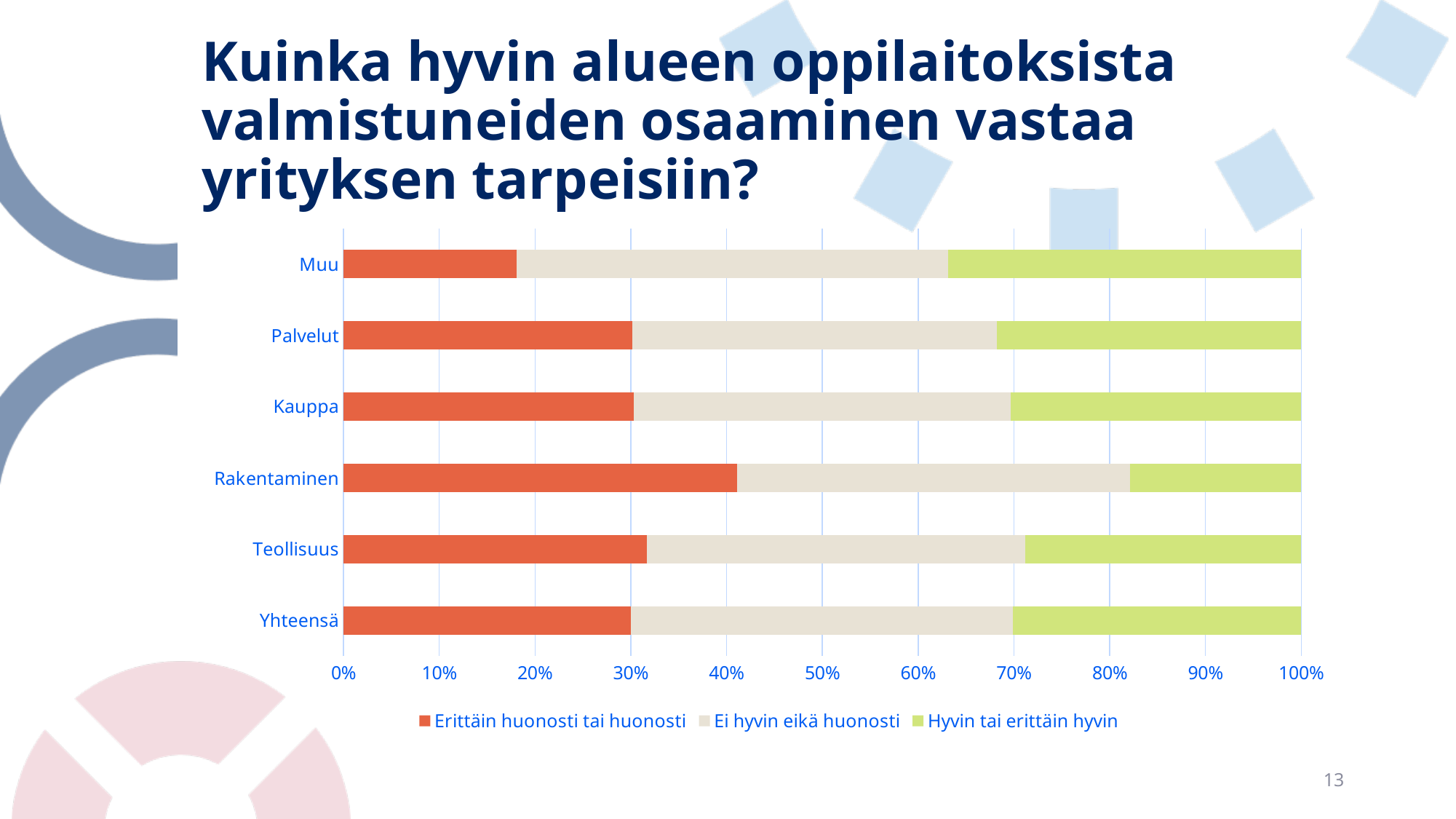
Is the 'Hyvin tai erittäin hyvin' value for Rakentaminen greater or less than 30%? less Which category has the largest 'Hyvin tai erittäin hyvin' segment? Muu What is the title of the slide containing the chart? Kuinka hyvin alueen oppilaitoksista valmistuneiden osaaminen vastaa yrityksen tarpeisiin? How many categories are shown on the vertical axis of the chart? 6 Which category has the smallest 'Hyvin tai erittäin hyvin' segment? Rakentaminen What kind of chart is shown on the slide? bar chart Which category has the smallest 'Erittäin huonosti tai huonosti' segment? Muu Which has a larger 'Erittäin huonosti tai huonosti' segment, Rakentaminen or Muu? Rakentaminen Which category has the largest 'Erittäin huonosti tai huonosti' segment? Rakentaminen How many series does the chart's legend list? 3 Is the 'Erittäin huonosti tai huonosti' value for Muu greater or less than 20%? less Is the 'Erittäin huonosti tai huonosti' value for Rakentaminen greater or less than 30%? greater